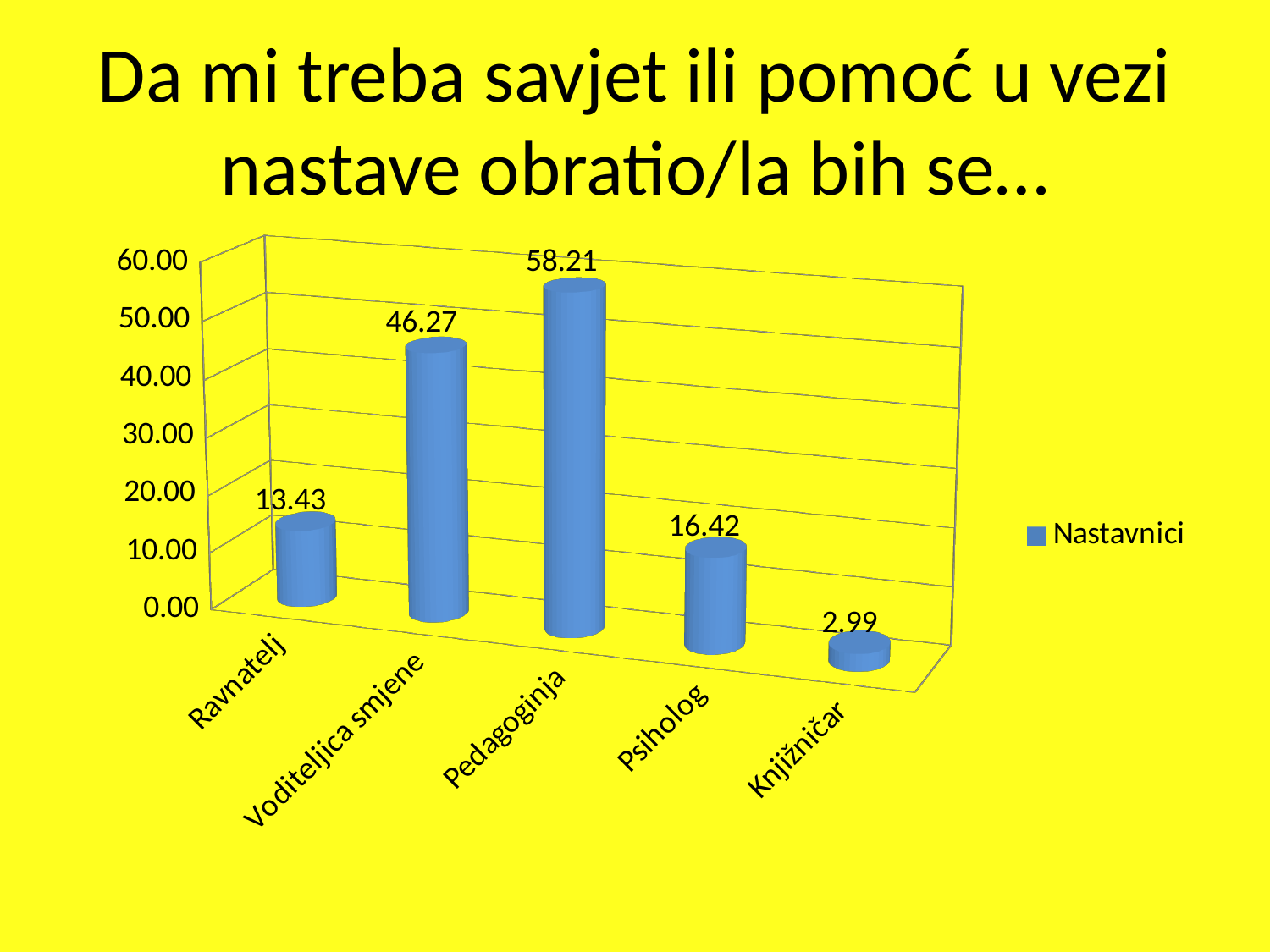
Is the value for Voditeljica smjene greater or less than 40.00? greater What is the value for Pedagoginja? 58.21 What kind of chart is shown on the slide? bar chart Which is larger, the value for Psiholog or the value for Ravnatelj? Psiholog Which category has the highest value? Pedagoginja What is the value for Knjižničar? 2.99 What is the name of the series shown in the legend? Nastavnici What is the difference between the values for Pedagoginja and Voditeljica smjene? 11.94 What is the value for Ravnatelj? 13.43 Which category has the lowest value? Knjižničar How many categories are shown on the x axis? 5 How many series does the legend list? 1